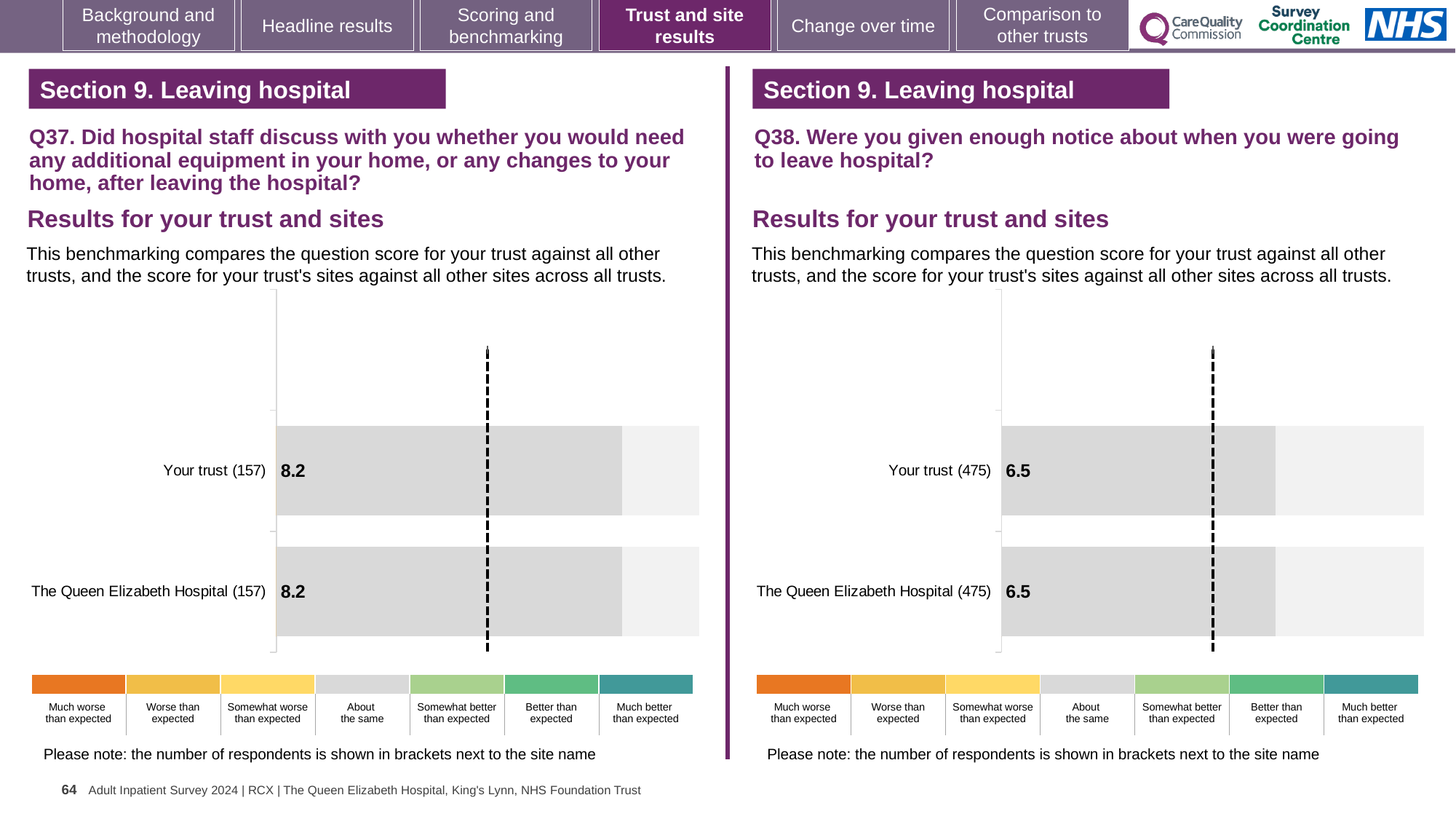
How many bars are plotted in the Q38 chart on the right? 2 What kind of chart is used for the Q37 results on the left? Bar chart In the Q37 chart on the left, how many respondents are shown in brackets for Your trust? 157 In the Q38 chart on the right, how many respondents are shown in brackets for The Queen Elizabeth Hospital? 475 In the Q38 chart on the right, what is the score for The Queen Elizabeth Hospital? 6.5 Is the score for Your trust in the Q37 chart on the left larger or smaller than the score for Your trust in the Q38 chart on the right? Larger How many bars are plotted in the Q37 chart on the left? 2 In the Q37 chart on the left, what is the score for Your trust? 8.2 In the Q37 chart on the left, what is the score for The Queen Elizabeth Hospital? 8.2 In the Q38 chart on the right, what is the difference between the score for Your trust and the score for The Queen Elizabeth Hospital? 0 In the Q38 chart on the right, what is the score for Your trust? 6.5 In the Q37 chart on the left, what is the difference between the score for Your trust and the score for The Queen Elizabeth Hospital? 0